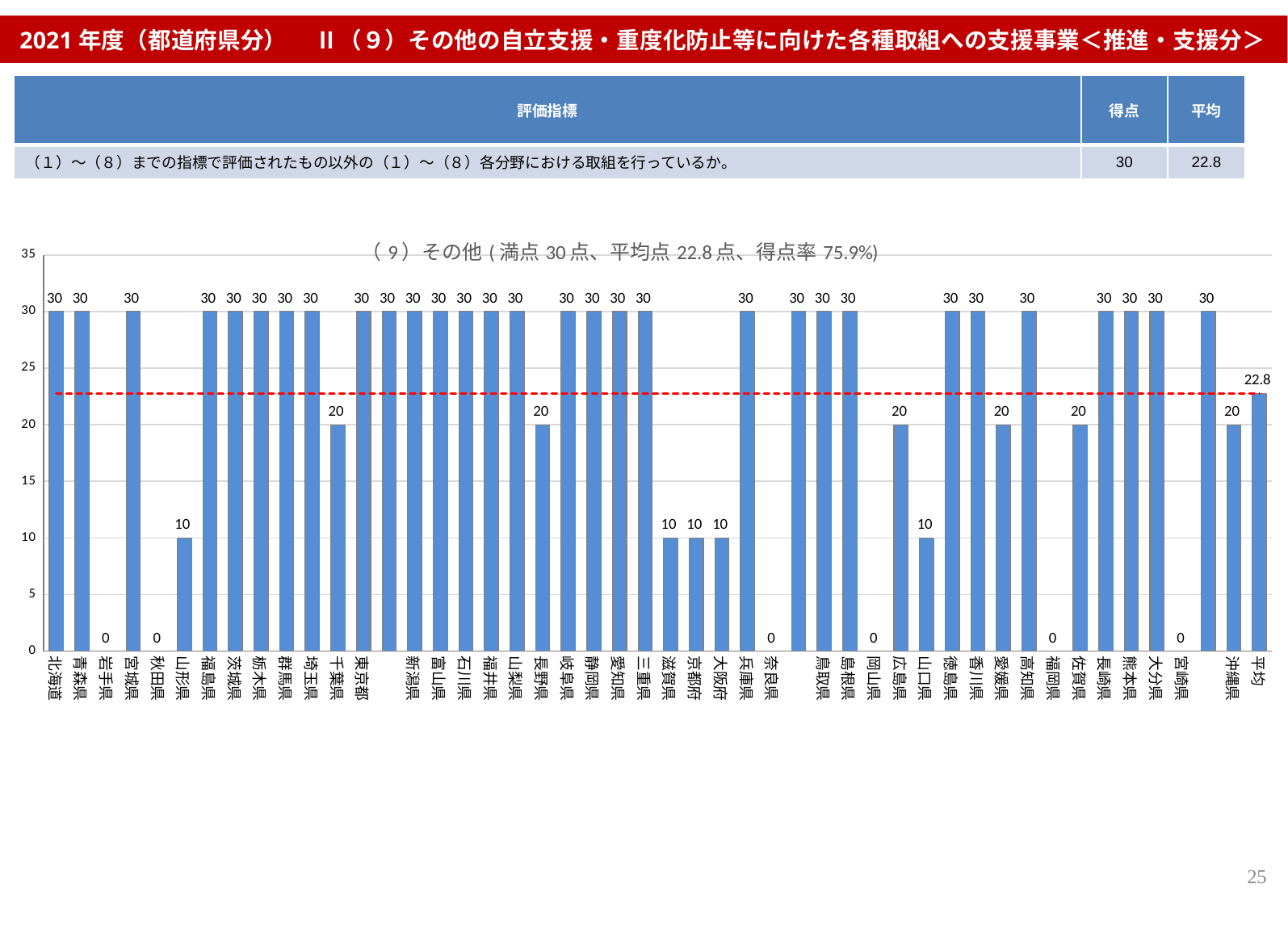
Is the value for 沖縄県 greater or less than 25? less What is the value for 広島県? 20 What value does the red dashed horizontal line mark? 22.8 What is the difference between the values for 広島県 and 山口県? 10 What is the value for 奈良県? 0 What is the difference between the values for 北海道 and 千葉県? 10 What is the value for 千葉県? 20 What kind of chart is shown on the slide? bar chart What is the value for 山形県? 10 Which is larger, the value for 滋賀県 or the value for 兵庫県? 兵庫県 What is the value for 平均 (the last bar)? 22.8